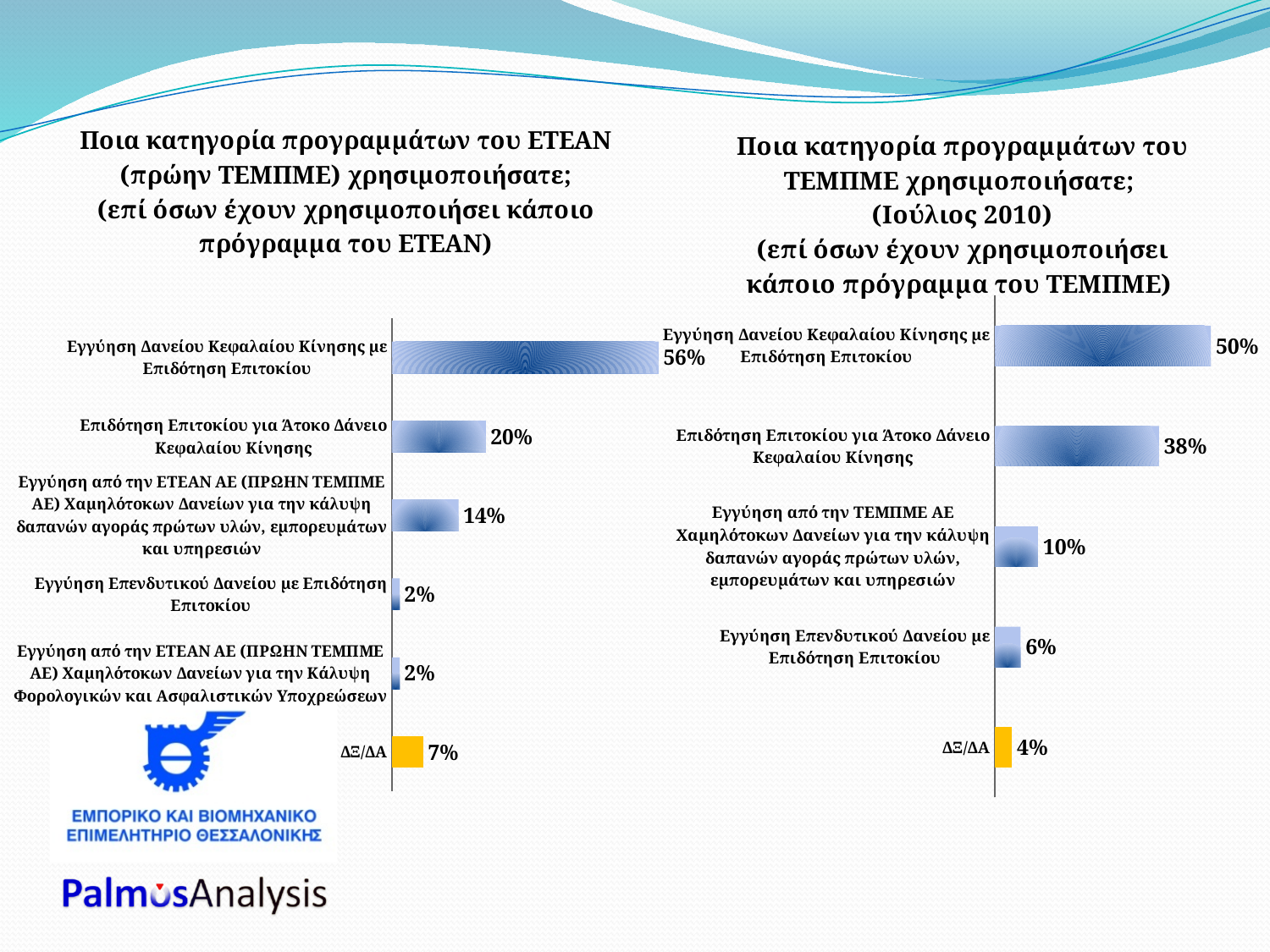
What type of chart is the left chart (ETEAN)? Bar chart How many categories are shown in the left chart (ETEAN)? 6 In the left chart (ETEAN), which bar is coloured differently (yellow) from the others? ΔΞ/ΔΑ In the right chart (ΤΕΜΠΜΕ, Ιούλιος 2010), which category has the lowest value? ΔΞ/ΔΑ In the left chart (ETEAN), what is the value for ΔΞ/ΔΑ? 7% Which is larger: the value for Εγγύηση Επενδυτικού Δανείου με Επιδότηση Επιτοκίου in the left chart (ETEAN) or in the right chart (ΤΕΜΠΜΕ, Ιούλιος 2010)? The right chart (ΤΕΜΠΜΕ, Ιούλιος 2010) How many categories are shown in the right chart (ΤΕΜΠΜΕ, Ιούλιος 2010)? 5 In the right chart (ΤΕΜΠΜΕ, Ιούλιος 2010), what is the difference between the values for Εγγύηση Δανείου Κεφαλαίου Κίνησης με Επιδότηση Επιτοκίου and Επιδότηση Επιτοκίου για Άτοκο Δάνειο Κεφαλαίου Κίνησης? 12% In the left chart (ETEAN), what is the difference between the values for Επιδότηση Επιτοκίου για Άτοκο Δάνειο Κεφαλαίου Κίνησης and Εγγύηση από την ΕΤΕΑΝ ΑΕ (ΠΡΩΗΝ ΤΕΜΠΜΕ ΑΕ) Χαμηλότοκων Δανείων για την κάλυψη δαπανών αγοράς πρώτων υλών, εμπορευμάτων και υπηρεσιών? 6% In the right chart (ΤΕΜΠΜΕ, Ιούλιος 2010), which category has the highest value? Εγγύηση Δανείου Κεφαλαίου Κίνησης με Επιδότηση Επιτοκίου In the left chart (ETEAN), what is the value for Εγγύηση Δανείου Κεφαλαίου Κίνησης με Επιδότηση Επιτοκίου? 56% In the right chart (ΤΕΜΠΜΕ, Ιούλιος 2010), what is the value for Επιδότηση Επιτοκίου για Άτοκο Δάνειο Κεφαλαίου Κίνησης? 38%